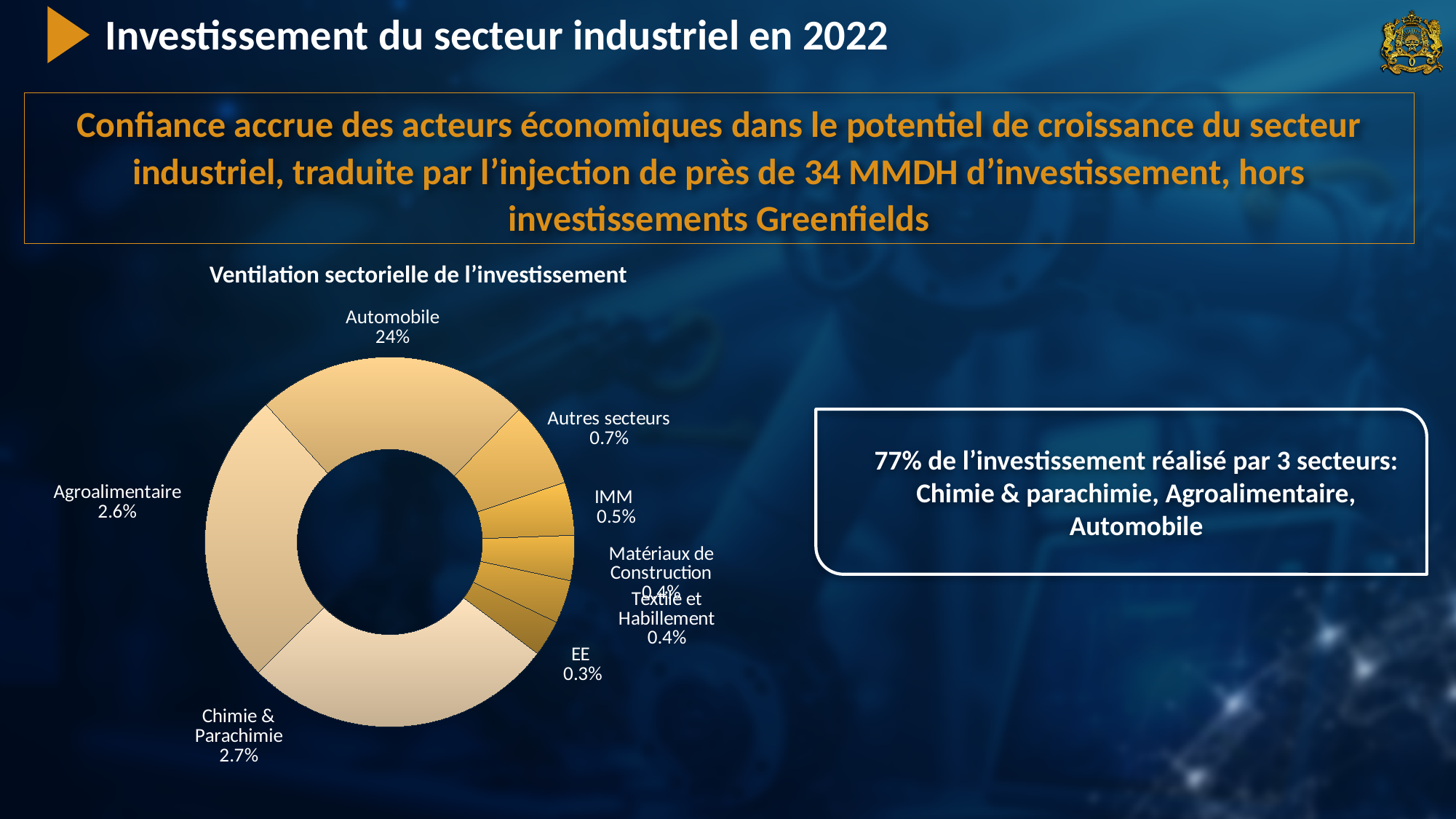
What is the share shown for EE? 0.3% Which has the larger share, Autres secteurs or EE? Autres secteurs What is the title of the chart on the slide? Ventilation sectorielle de l'investissement How many sectors are shown in the chart? 8 Which sector has the smallest share shown in the chart? EE What percentage share does Automobile have in the Ventilation sectorielle de l'investissement chart? 24% What is the share shown for Agroalimentaire? 2.6% What is the share shown for Autres secteurs? 0.7% What is the difference between the shares of Autres secteurs and IMM? 0.2 percentage points What kind of chart is used to show the sector breakdown of investment? Doughnut chart What is the share shown for Chimie & Parachimie? 2.7% What is the share shown for IMM? 0.5%